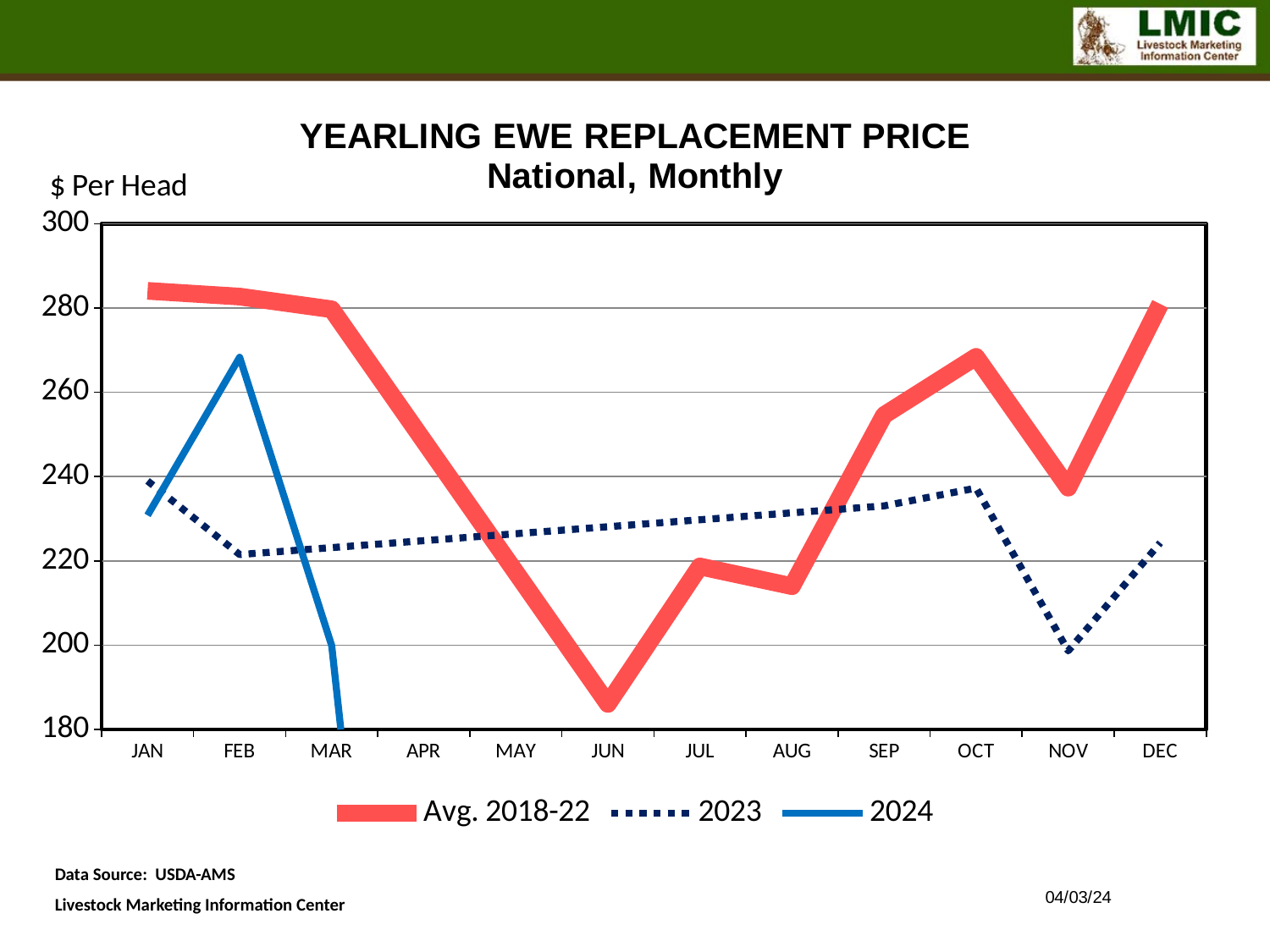
In which month is the 2023 series at its lowest? NOV In which month is the Avg. 2018-22 series at its lowest? JUN Is the 2024 value for FEB greater or less than 260? greater Is the 2023 value for NOV greater or less than 220? less What unit is shown on the y axis? $ Per Head What kind of chart is shown on the slide? line chart Does the Avg. 2018-22 series rise or fall from MAR to JUN? fall Is the Avg. 2018-22 value for JUN greater or less than 200? less In FEB, which series is higher: 2023 or 2024? 2024 In JUN, which series is higher: Avg. 2018-22 or 2023? 2023 How many months are shown along the x axis? 12 How many series does the legend list? 3